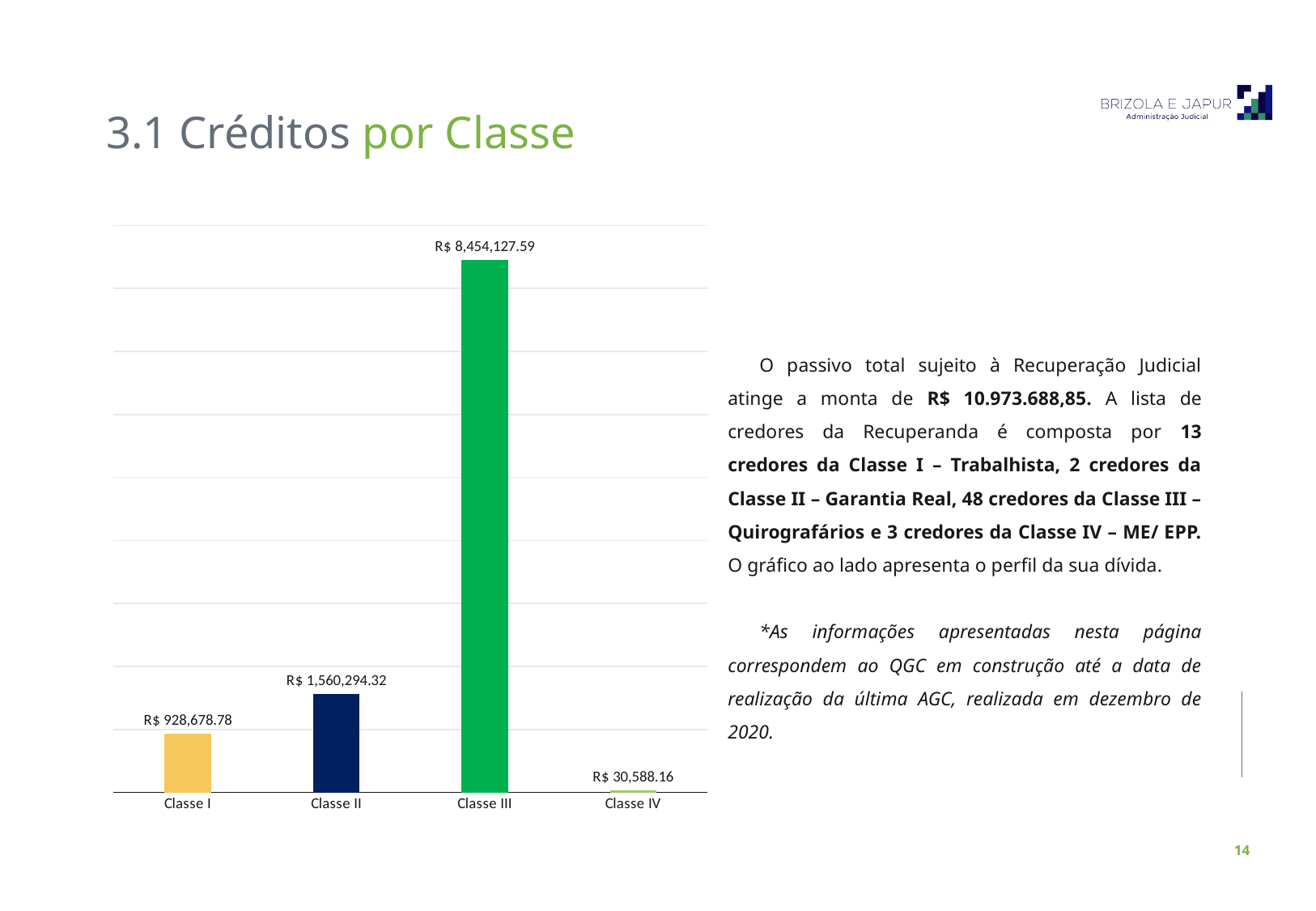
What kind of chart is shown on the slide? Bar chart How many classes are shown on the chart? 4 What is the value shown for Classe I? R$ 928,678.78 What is the difference between the values for Classe II and Classe I? R$ 631,615.54 What is the value shown for Classe IV? R$ 30,588.16 Which class has the highest value? Classe III Which class has the lowest value? Classe IV What colour is the bar for Classe I? Yellow What is the value shown for Classe III? R$ 8,454,127.59 What is the difference between the values for Classe III and Classe II? R$ 6,893,833.27 Which is larger, the value for Classe I or the value for Classe II? Classe II What is the value shown for Classe II? R$ 1,560,294.32